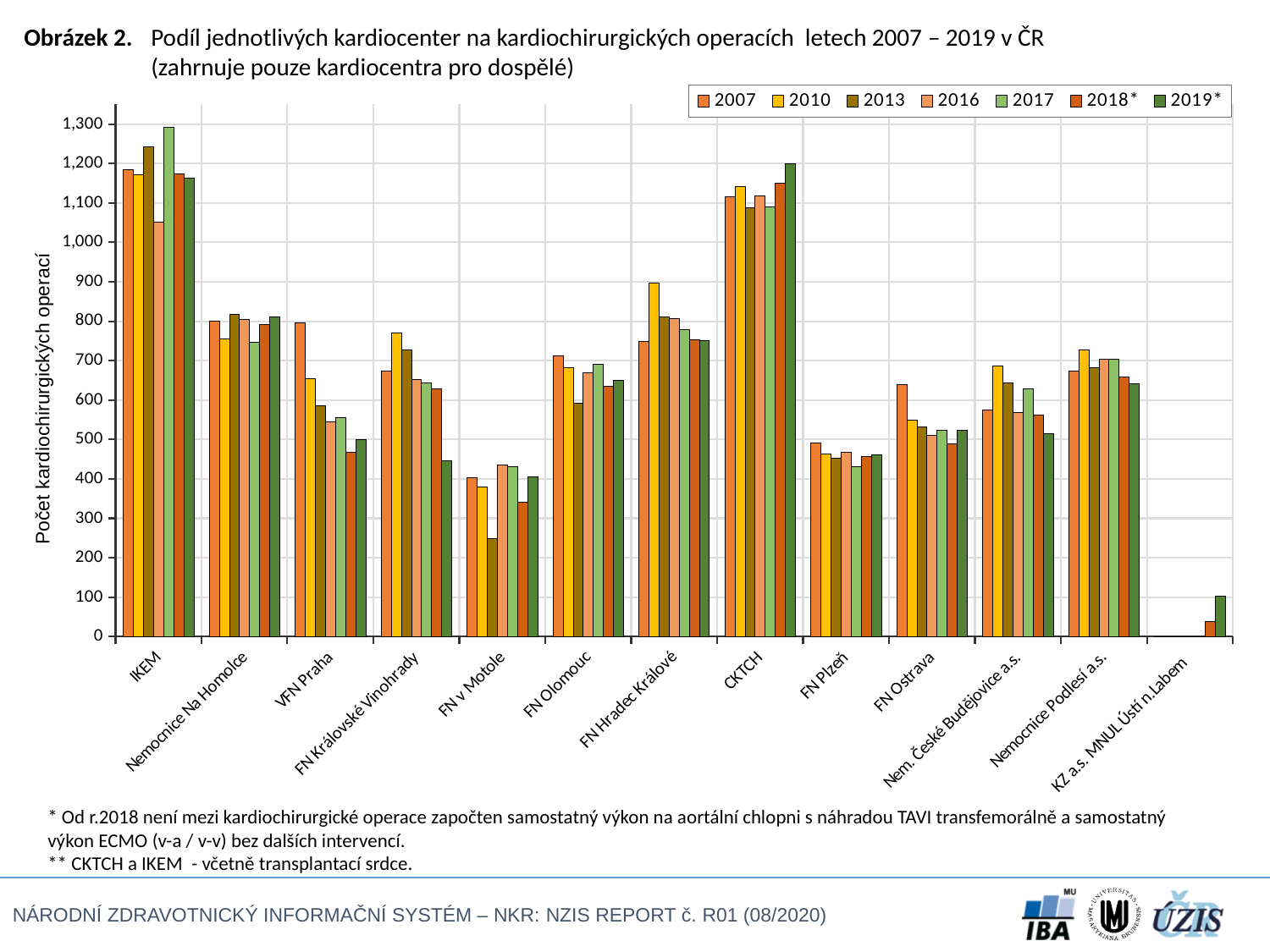
Is the value for IKEM in 2017 greater or less than 1,200? greater What is the label of the y axis? Počet kardiochirurgických operací Which cardiocenter has the lowest value for 2019*? KZ a.s. MNUL Ústí n.Labem How many series does the legend list? 7 Is the value for FN v Motole in 2013 greater or less than 300? less How many cardiocenters (categories) are shown on the x axis? 13 Which is larger, the 2007 value for IKEM or the 2007 value for CKTCH? IKEM Is the value for KZ a.s. MNUL Ústí n.Labem in 2018* greater or less than 100? less Which is larger, the 2019* value for Nemocnice Na Homolce or the 2019* value for FN Olomouc? Nemocnice Na Homolce Which cardiocenter has the highest value for 2017? IKEM What kind of chart is shown on the slide? bar chart